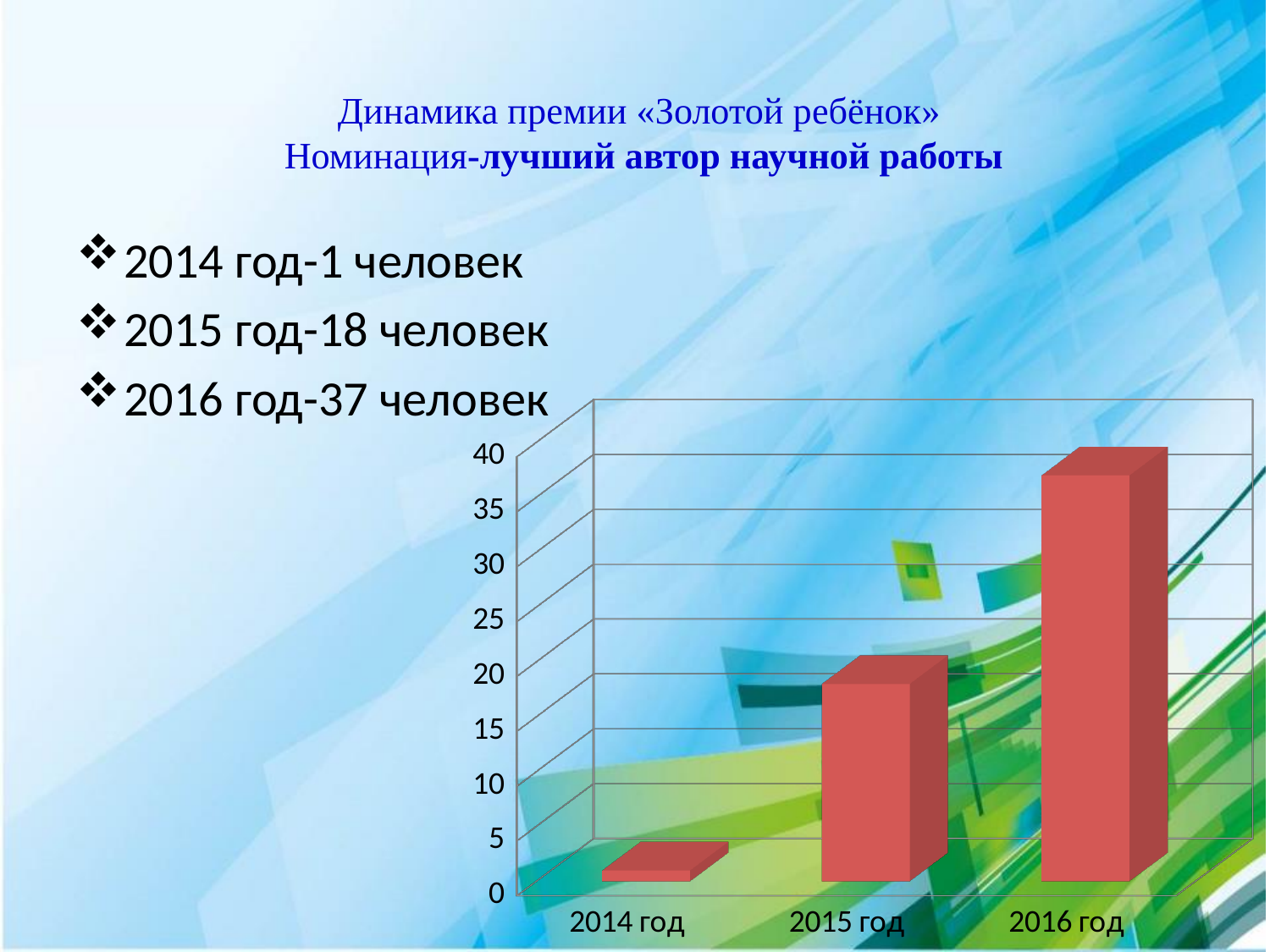
What kind of chart is shown on the slide? bar chart Is the value for 2014 год greater or less than 5? less What is the highest value shown on the chart's vertical axis? 40 Is the value for 2016 год greater or less than 30? greater Is the value for 2015 год greater or less than 20? less Which year has the highest bar in the chart? 2016 год According to the slide, how many people does the bar for 2016 год represent? 37 человек Which is larger, the value for 2015 год or the value for 2016 год? 2016 год Which year has the lowest bar in the chart? 2014 год Do the values rise or fall from 2014 год to 2016 год? rise How many categories (years) are shown on the x axis of the chart? 3 According to the slide, how many people does the bar for 2015 год represent? 18 человек